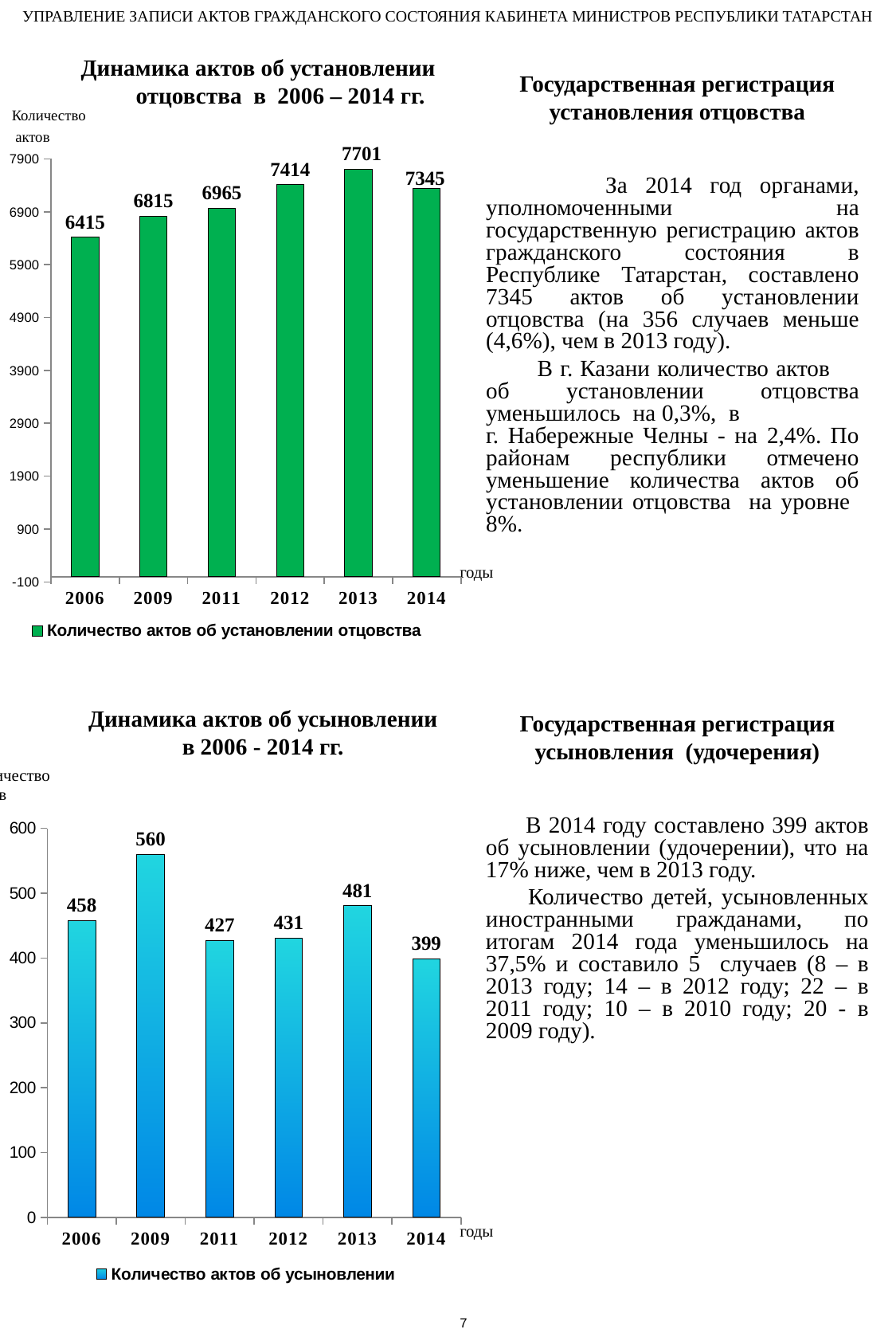
In the top chart (Динамика актов об установлении отцовства), how many years are shown on the x axis? 6 In the bottom chart (Динамика актов об усыновлении), is the value for 2014 greater or less than 400? less In the top chart (Динамика актов об установлении отцовства), which year has the highest value? 2013 In the bottom chart (Динамика актов об усыновлении), which year has the lowest value? 2014 In the bottom chart (Динамика актов об усыновлении), what is the value for 2009? 560 In the top chart (Динамика актов об установлении отцовства), what is the value for 2012? 7414 What type of chart is the top chart (Динамика актов об установлении отцовства)? bar chart In the bottom chart (Динамика актов об усыновлении), what is the difference between the values for 2013 and 2014? 82 In the bottom chart (Динамика актов об усыновлении), which is larger, the value for 2011 or the value for 2013? 2013 What is the legend entry of the bottom chart (Динамика актов об усыновлении)? Количество актов об усыновлении In the top chart (Динамика актов об установлении отцовства), which year has the lowest value? 2006 In the top chart (Динамика актов об установлении отцовства), what is the difference between the values for 2013 and 2014? 356